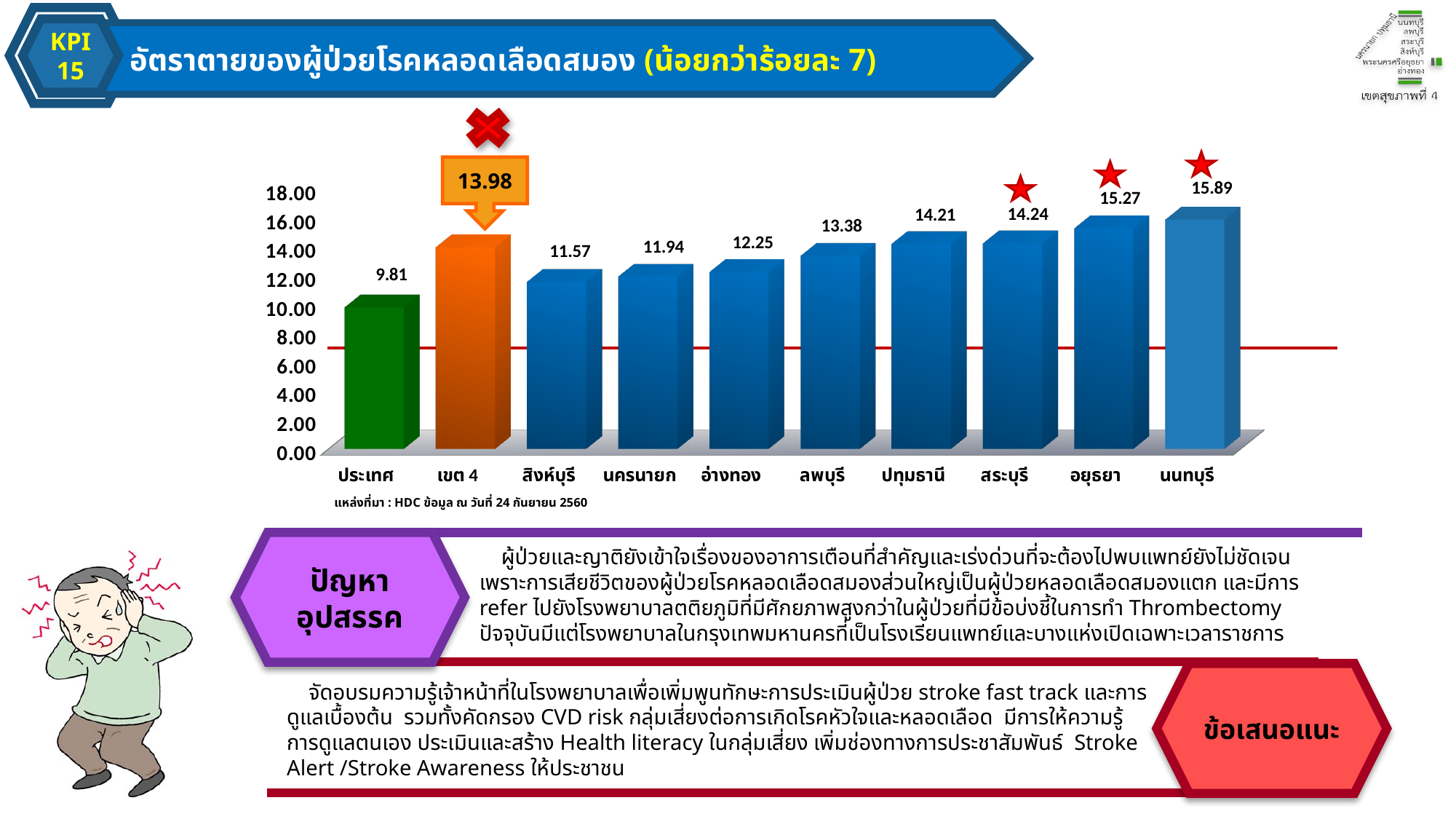
What is the value for ลพบุรี? 13.38 What is the difference between the values for นนทบุรี and ประเทศ? 6.08 Which is larger, the value for อยุธยา or the value for สิงห์บุรี? อยุธยา What is the value for นนทบุรี? 15.89 What is the value for เขต 4? 13.98 Which category has the lowest value? ประเทศ Which category has the highest value? นนทบุรี What kind of chart is shown on the slide? bar chart What is the value for ประเทศ? 9.81 What colour is the bar for เขต 4? orange How many categories are shown on the x axis? 10 Is the value for อ่างทอง greater or less than 10.00? greater